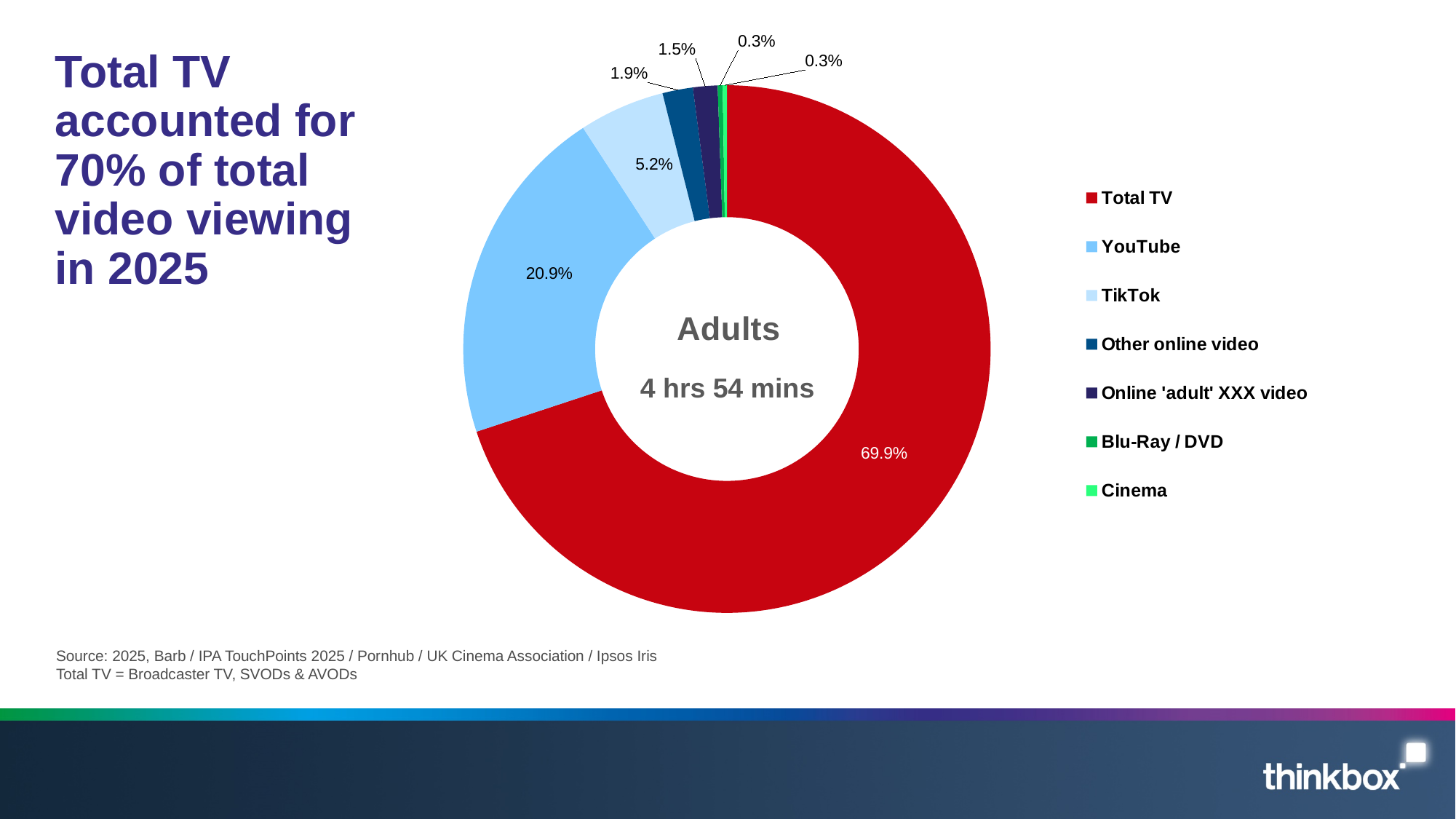
What colour is the Total TV segment of the chart? Red What share of total video viewing does YouTube account for? 20.9% What is the difference in share between Total TV and YouTube? 49.0 percentage points What kind of chart is shown on the slide? Donut (pie) chart What share of total video viewing does Total TV account for? 69.9% What share of total video viewing does TikTok account for? 5.2% What share of total video viewing does Online 'adult' XXX video account for? 1.5% What share of total video viewing does Other online video account for? 1.9% Which category has the largest share of total video viewing? Total TV Which has a larger share, TikTok or Other online video? TikTok How many categories does the legend list? 7 What text appears in the centre of the donut chart? Adults 4 hrs 54 mins